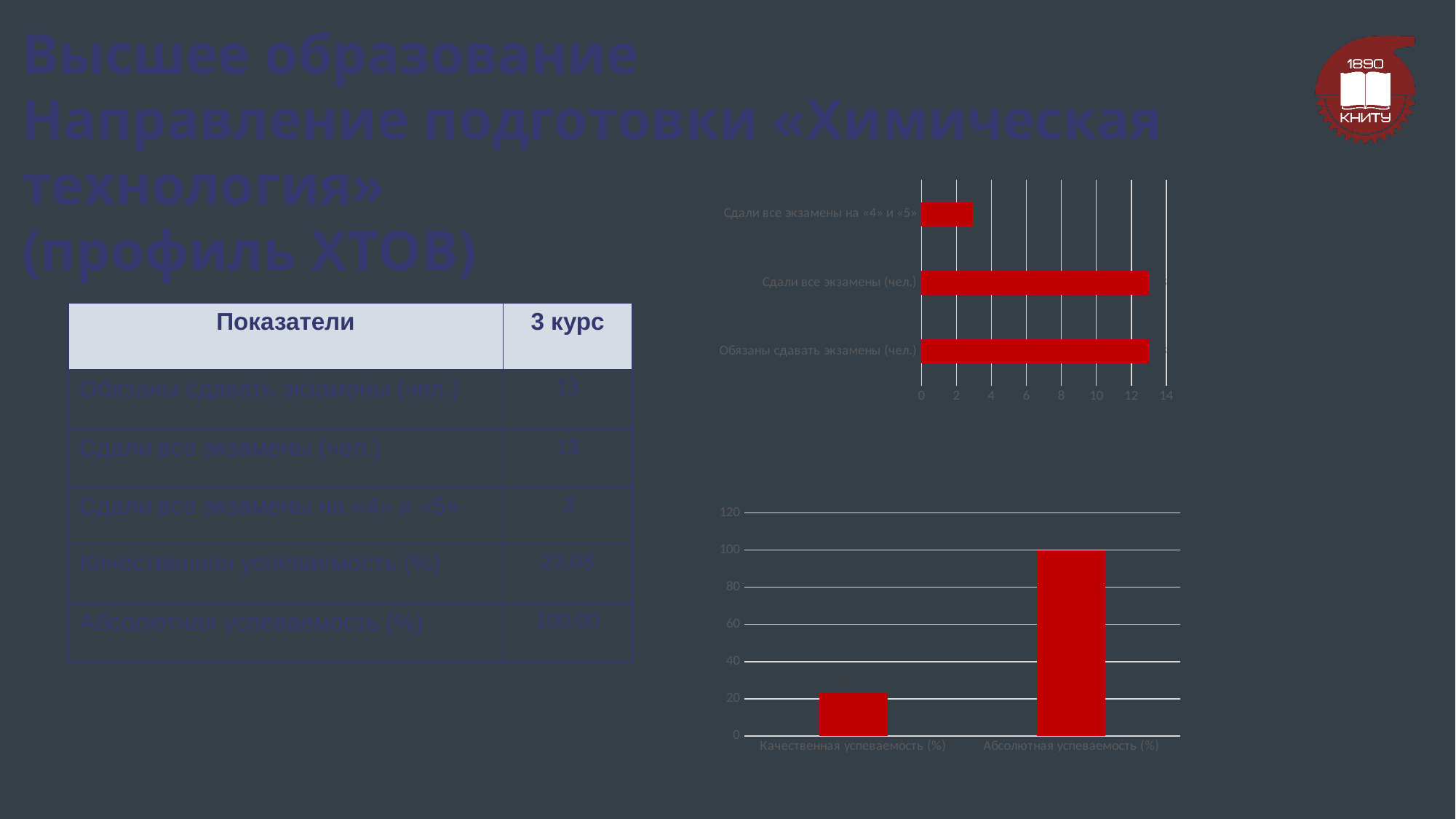
In the bottom-right bar chart, what value does the bar for «Абсолютная успеваемость (%)» reach on the axis? 100 How many categories does the top-right horizontal bar chart show? 3 What kind of chart is the bottom-right chart on the slide? bar chart In the top-right horizontal bar chart, is the value for «Сдали все экзамены на «4» и «5»» greater or less than 4? less What kind of chart is the top-right chart on the slide? bar chart In the top-right horizontal bar chart, which is larger: «Сдали все экзамены (чел.)» or «Сдали все экзамены на «4» и «5»»? Сдали все экзамены (чел.) In the bottom-right bar chart, which category has the highest value? Абсолютная успеваемость (%) In the top-right horizontal bar chart, which category has the lowest value? Сдали все экзамены на «4» и «5» In the bottom-right bar chart, is the value for «Качественная успеваемость (%)» greater or less than 40? less What colour are the bars in the bottom-right bar chart? red In the top-right horizontal bar chart, is the value for «Сдали все экзамены (чел.)» greater or less than 12? greater How many categories does the bottom-right bar chart show? 2